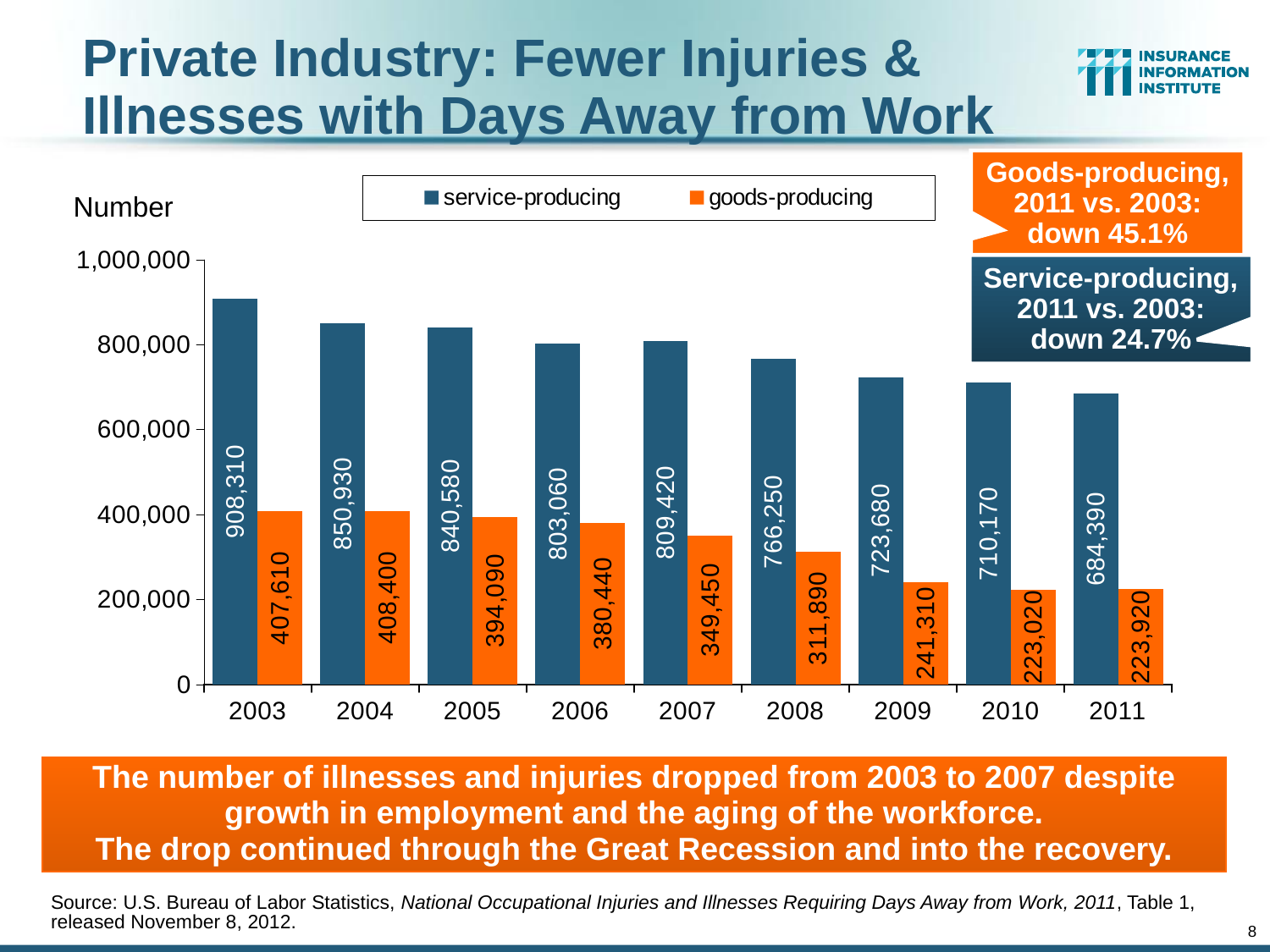
What is the value for goods-producing in 2008? 311,890 Do the service-producing values generally rise or fall from 2003 to 2011? fall What kind of chart is shown on the slide? bar chart How many series does the legend list? 2 Which year has the highest goods-producing value? 2004 What is the difference between the service-producing and goods-producing values in 2003? 500,700 Is the service-producing value for 2007 greater or less than 800,000? greater Which year has the lowest service-producing value? 2011 What is the value for service-producing in 2003? 908,310 How many years are shown on the x axis? 9 Which is larger, the goods-producing value in 2009 or in 2010? 2009 What is the value for goods-producing in 2011? 223,920